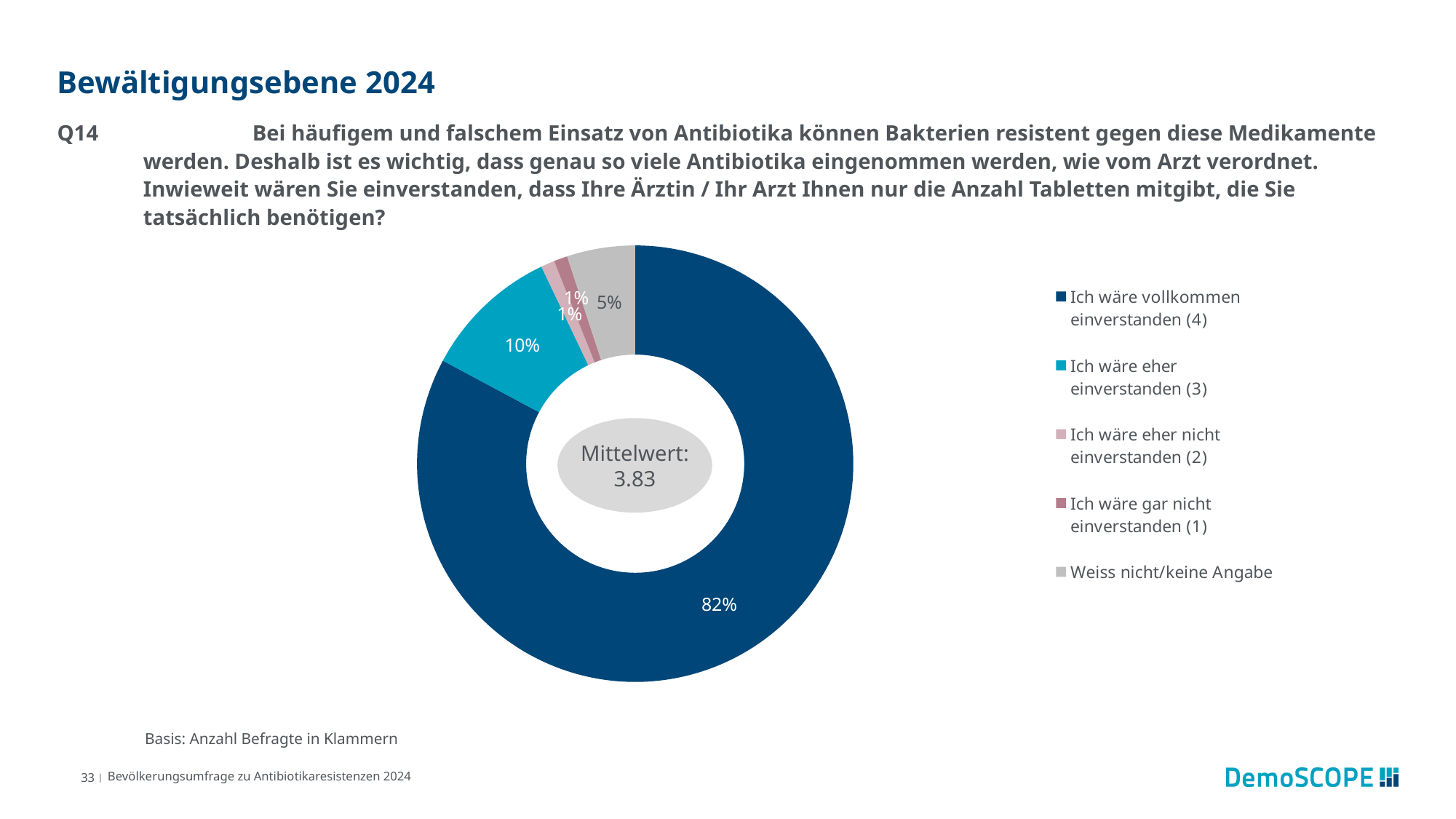
What Mittelwert (mean value) is shown in the centre of the chart? 3.83 How many slices does the chart have? 5 Which is larger: the share for "Ich wäre eher einverstanden (3)" or the share for "Weiss nicht/keine Angabe"? Ich wäre eher einverstanden (3) What share of respondents answered "Weiss nicht/keine Angabe"? 5% What share of respondents answered "Ich wäre eher einverstanden (3)"? 10% What share of respondents answered "Ich wäre vollkommen einverstanden (4)"? 82% How many entries does the legend list? 5 Which colour represents "Ich wäre eher einverstanden (3)" in the chart? Light blue (turquoise) What share of respondents answered "Ich wäre gar nicht einverstanden (1)"? 1% Which answer category has the largest share in the chart? Ich wäre vollkommen einverstanden (4) What is the difference in percentage points between "Ich wäre vollkommen einverstanden (4)" and "Ich wäre eher einverstanden (3)"? 72 percentage points What kind of chart is shown on the slide? Pie (donut) chart